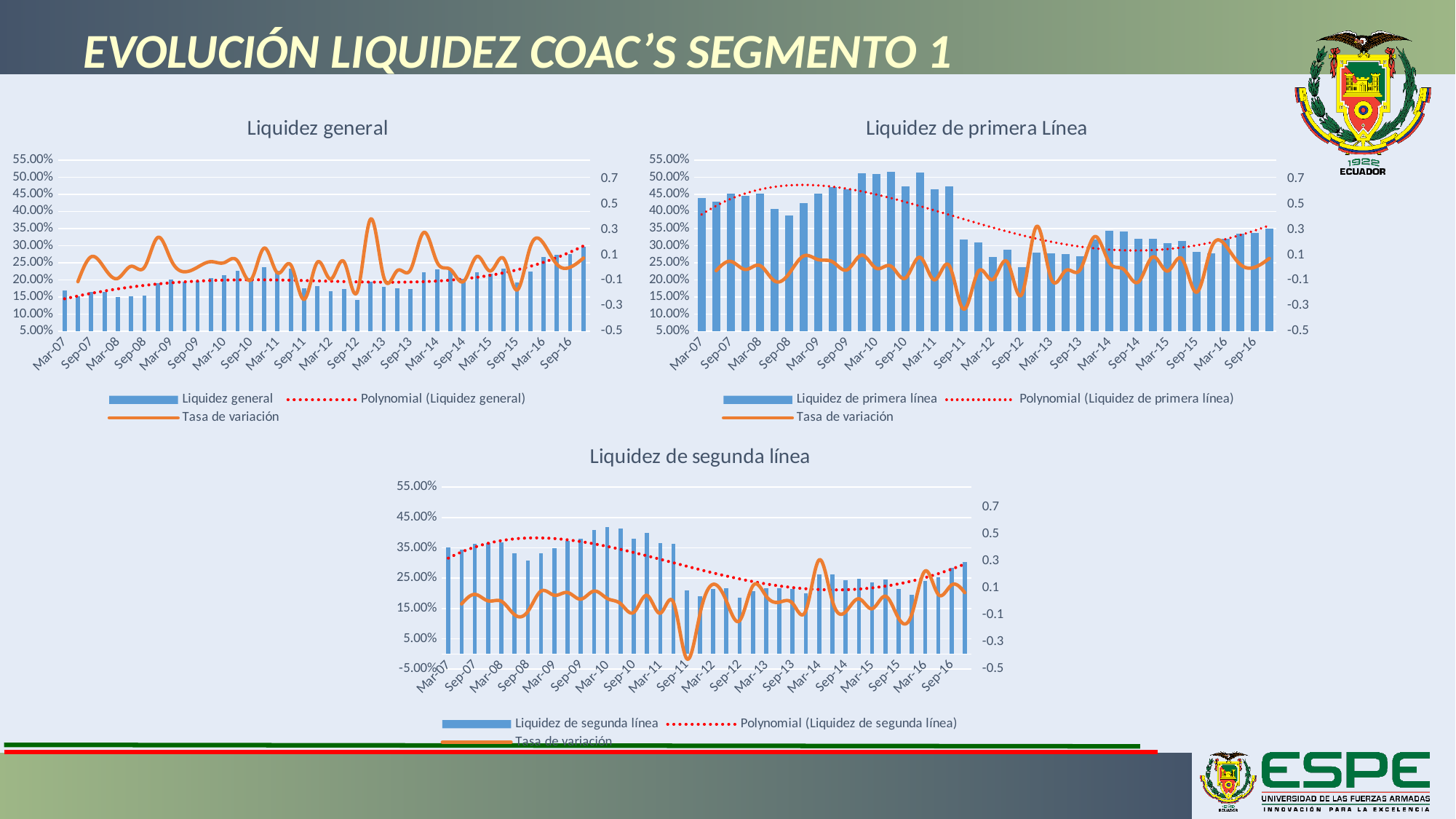
How many charts are shown on the slide? 3 In the 'Liquidez de primera Línea' chart, is the value for Sep-11 greater or less than 35.00%? less In the 'Liquidez de segunda línea' chart, what does the orange solid line represent according to the legend? Tasa de variación In the 'Liquidez de primera Línea' chart, is the value for Mar-10 greater or less than 45.00%? greater In the 'Liquidez general' chart, which bar is taller, Mar-13 or Sep-16? Sep-16 In the 'Liquidez general' chart, is the value for Mar-07 greater or less than 20.00%? less How many series does the legend of the 'Liquidez de primera Línea' chart list? 3 What kind of chart is the 'Liquidez general' chart? bar and line chart In the 'Liquidez de primera Línea' chart, which bar is taller, Mar-10 or Mar-12? Mar-10 In the 'Liquidez general' chart, does the dotted polynomial trend line rise or fall from Mar-07 to Sep-16? rise